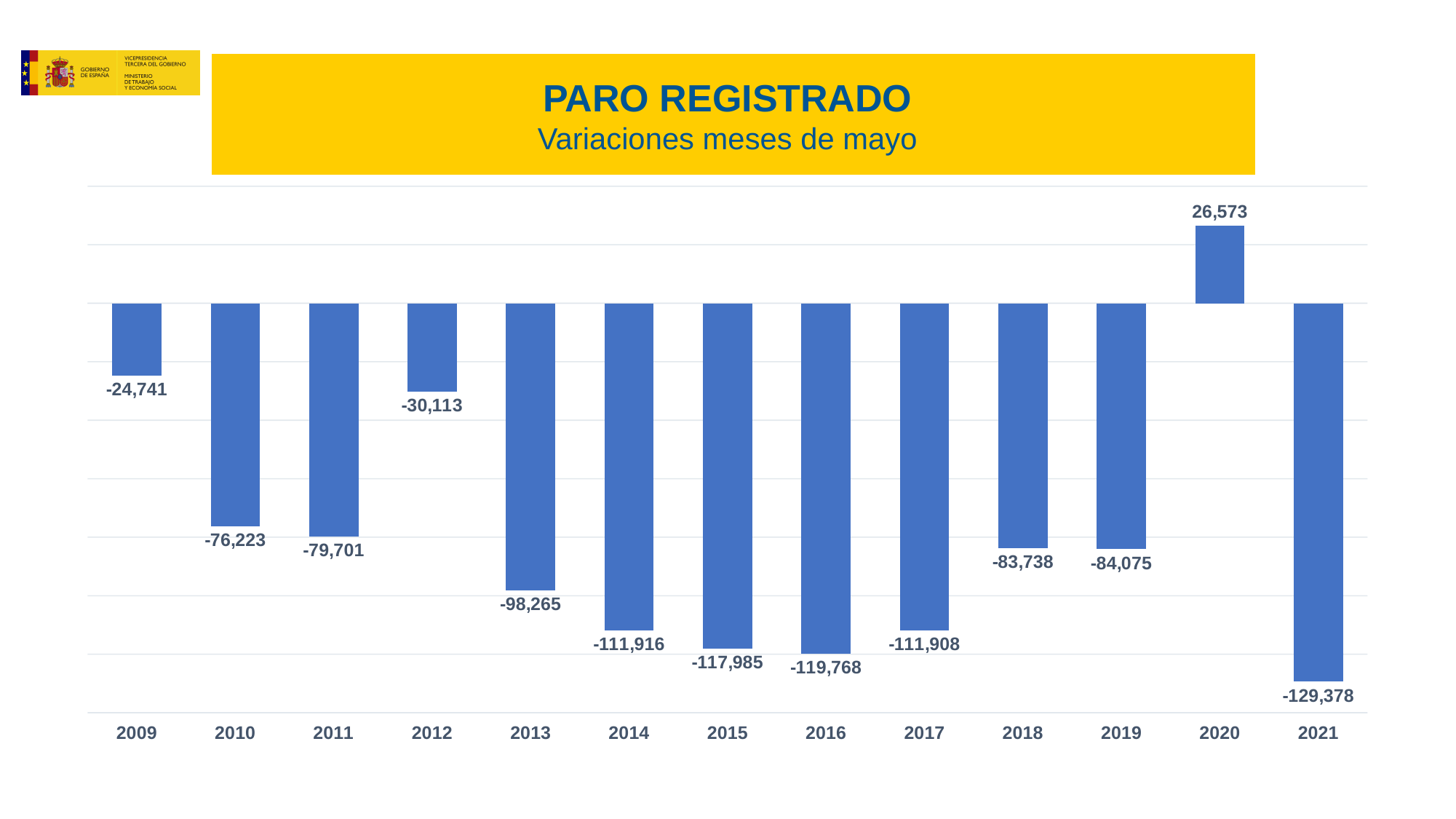
Do the values rise or fall from 2013 to 2016? Fall How many years are shown on the x axis? 13 What is the difference between the values for 2011 and 2010? 3,478 What is the value shown for 2009? -24,741 What kind of chart is this? Bar chart What is the difference between the values for 2021 and 2016? 9,610 Which year has the lowest value? 2021 Which value is larger, 2009 or 2012? 2009 What is the value shown for 2020? 26,573 What is the value shown for 2021? -129,378 What is the value shown for 2013? -98,265 Which year has the highest value? 2020